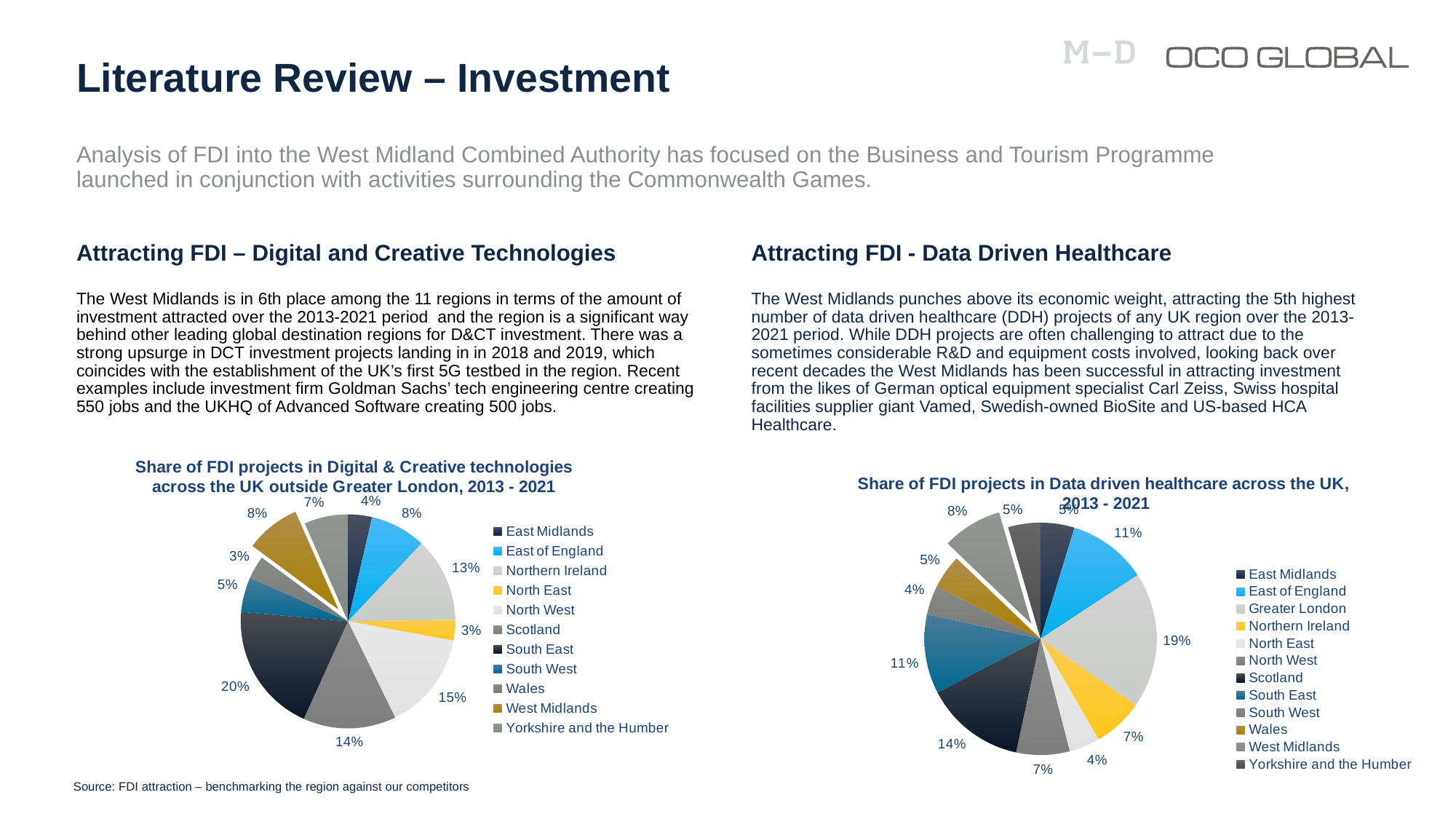
In the right chart (Share of FDI projects in Data driven healthcare), what is the difference between the Scotland share and the Northern Ireland share? 7% In the left chart (Share of FDI projects in Digital & Creative technologies), which is larger, Northern Ireland or East of England? Northern Ireland In the left chart (Share of FDI projects in Digital & Creative technologies), how many regions does the legend list? 11 What type of chart is used on the left of the slide for the Digital & Creative technologies data? Pie chart In the right chart (Share of FDI projects in Data driven healthcare), what share does the West Midlands have? 8% In the left chart (Share of FDI projects in Digital & Creative technologies), what share does Scotland have? 14% In the left chart (Share of FDI projects in Digital & Creative technologies), what share does the West Midlands have? 8% In the right chart (Share of FDI projects in Data driven healthcare), what share does Greater London have? 19% In the left chart (Share of FDI projects in Digital & Creative technologies), which region has the largest share? South East In the right chart (Share of FDI projects in Data driven healthcare), how many regions does the legend list? 12 In the left chart (Share of FDI projects in Digital & Creative technologies), what is the difference between the South East share and the North West share? 5% In the right chart (Share of FDI projects in Data driven healthcare), which region has the largest share? Greater London